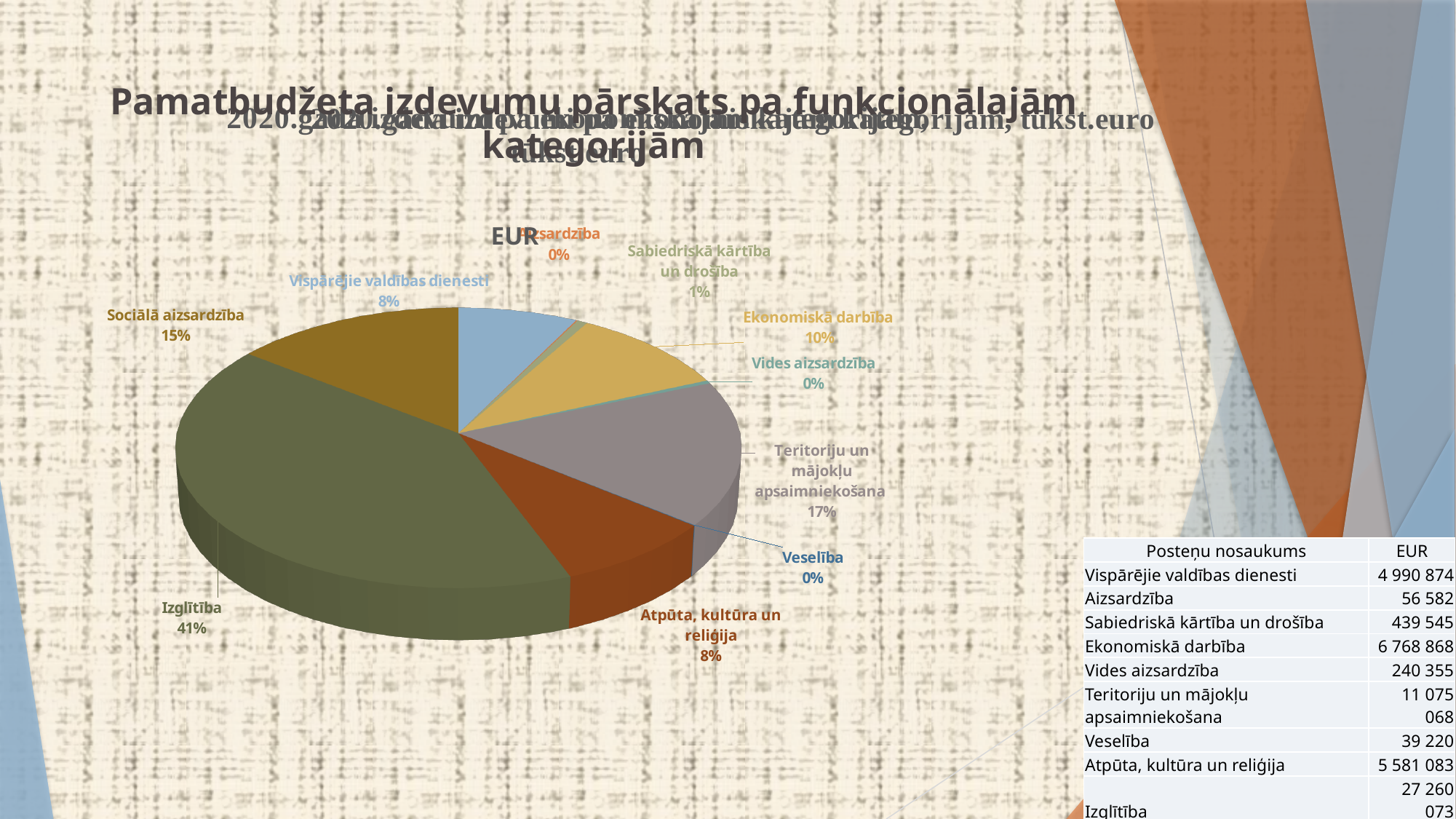
Which is larger, the slice for Sociālā aizsardzība or the slice for Ekonomiskā darbība? Sociālā aizsardzība What share of the pie does Teritoriju un mājokļu apsaimniekošana have? 17% What share of the pie does Izglītība have? 41% What percentage is shown for Vispārējie valdības dienesti? 8% What share of the pie does Ekonomiskā darbība have? 10% What kind of chart is shown on the slide? pie chart Which category has the largest slice of the pie? Izglītība What is the chart's title? EUR What percentage is shown for Sabiedriskā kārtība un drošība? 1% How many slices does the pie chart have? 10 What is the difference in percentage points between Izglītība and Teritoriju un mājokļu apsaimniekošana? 24